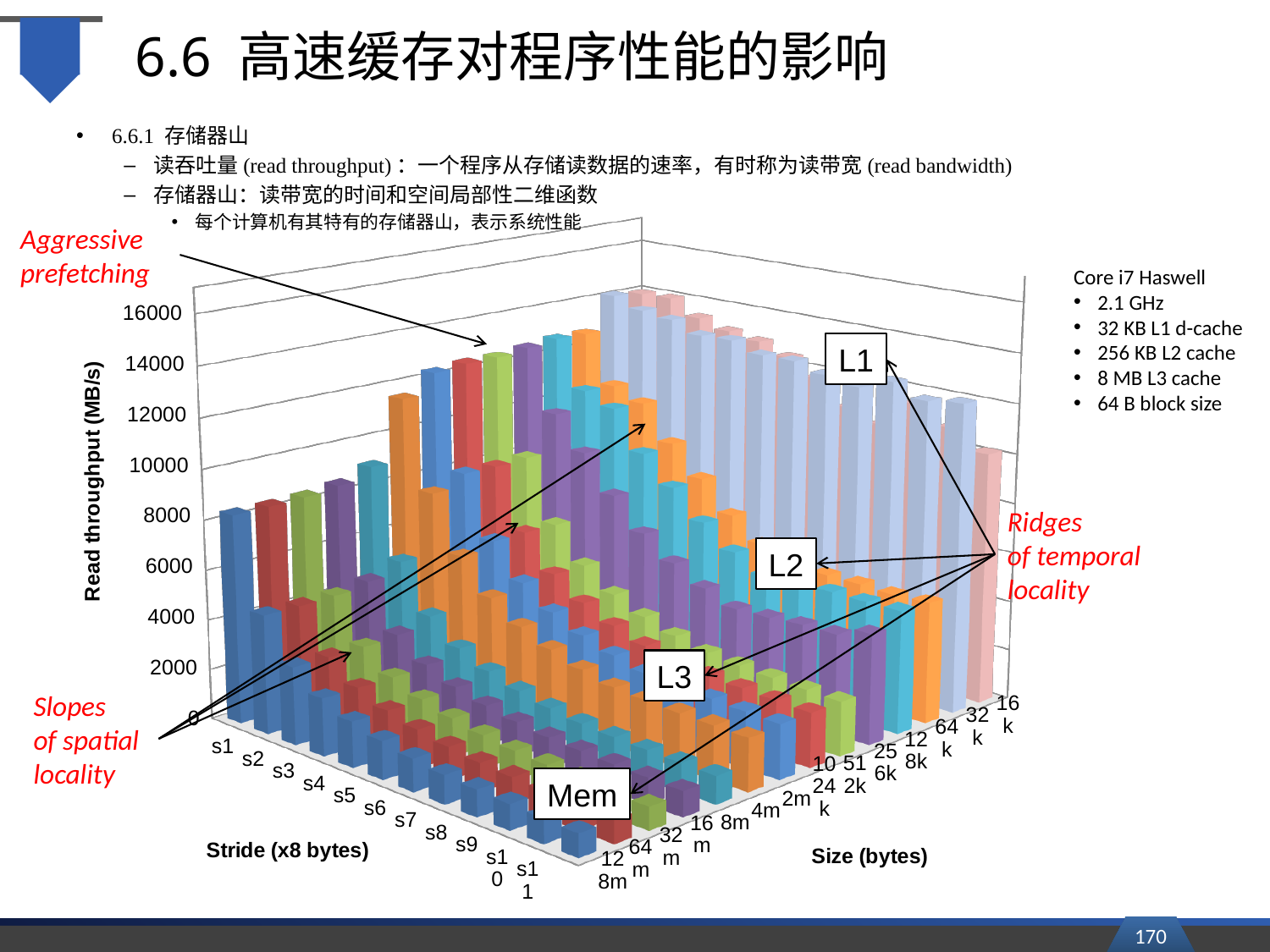
For the largest working-set sizes (the Mem region), does read throughput rise or fall as the stride increases from s1 to s11? fall What is the label of the axis that runs from s1 to s11? Stride (x8 bytes) What is the interval between consecutive ticks on the Read throughput axis? 2000 What kind of chart is shown on the slide? 3D bar chart Which region of the chart, L1 or Mem, has the higher read throughput? L1 Which labelled region of the memory mountain has the highest read throughput? L1 How many stride categories (s1 through s11) are shown on the stride axis? 11 What is the smallest size label shown on the Size (bytes) axis? 16k What is the highest tick value shown on the Read throughput axis? 16000 Which labelled region of the memory mountain has the lowest read throughput? Mem What is the title of the vertical axis of the chart? Read throughput (MB/s) Is the tallest bar in the chart greater or less than 12000 MB/s? greater